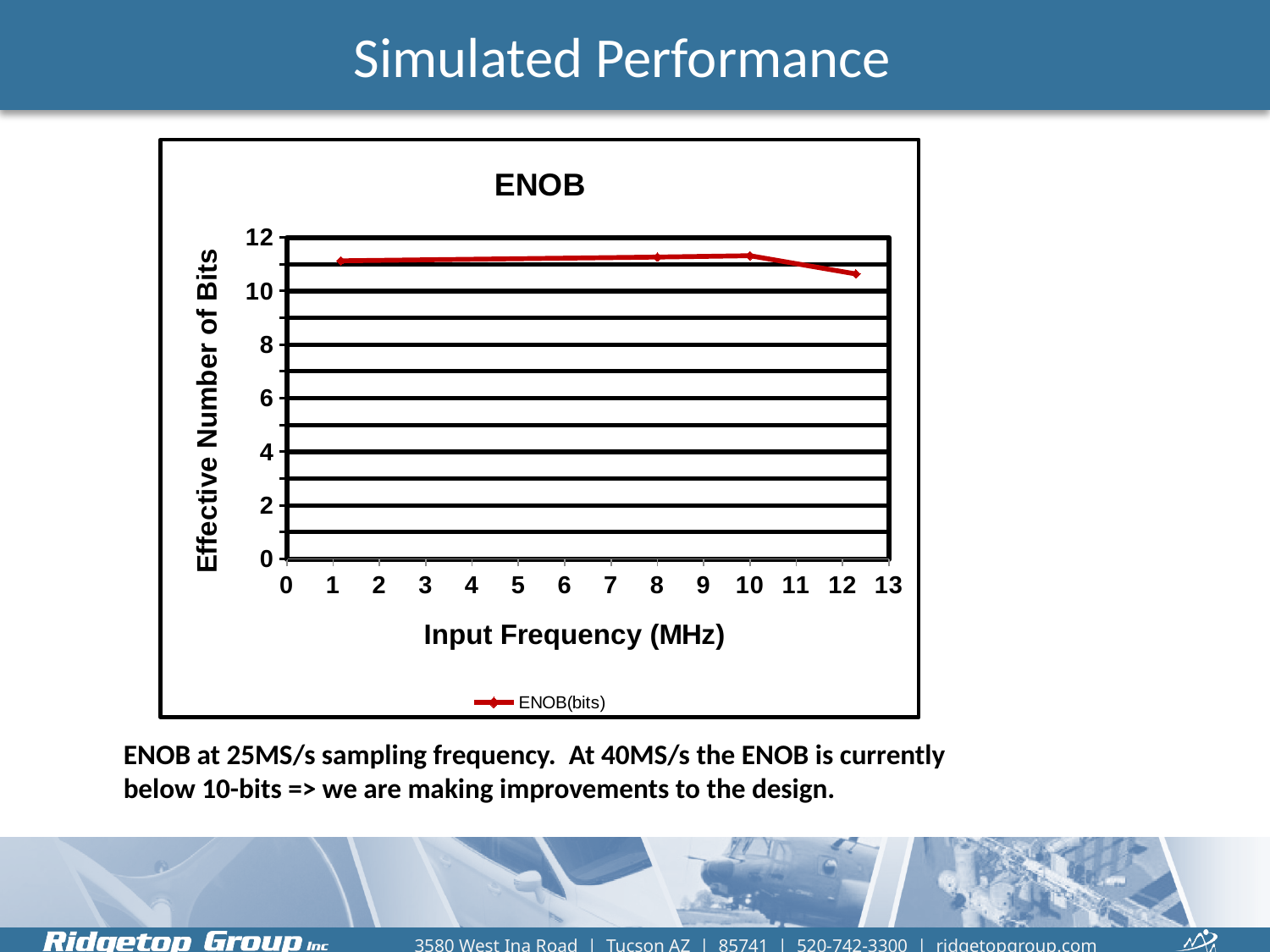
Does the ENOB rise or fall between the point at 10 MHz and the last point at around 12 MHz? fall How many data points are plotted on the line? 4 What is the label of the series in the legend? ENOB(bits) Is the ENOB value at the highest plotted input frequency (around 12 MHz) greater or less than 10? greater What is the title of the chart? ENOB Which is larger: the ENOB at the first plotted point (around 1 MHz) or at the last plotted point (around 12 MHz)? the first point (around 1 MHz) Is the ENOB value at the lowest plotted input frequency (around 1 MHz) greater or less than 12? less Are all plotted ENOB values greater or less than 8? greater What kind of chart is shown on the slide? line chart How many series does the legend list? 1